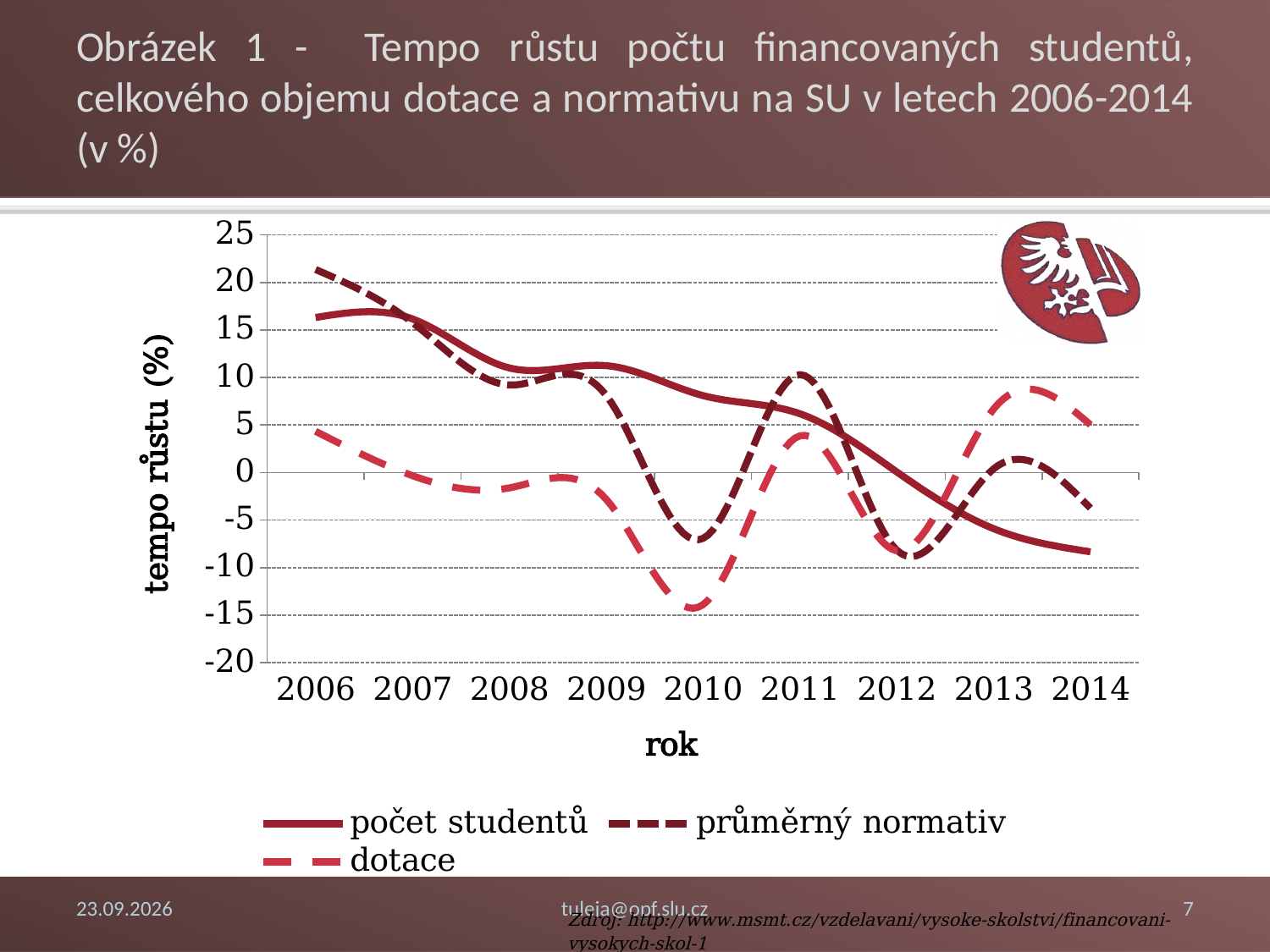
Is the value for 'počet studentů' in 2006 greater or less than 15? greater In which year does the 'dotace' series reach its lowest value? 2010 Is the value for 'dotace' in 2010 greater or less than -10? less How many years are plotted along the x axis? 9 Does the 'počet studentů' series rise or fall from 2006 to 2014? fall What kind of chart is shown on the slide? line chart In 2010, which series has the higher value, 'počet studentů' or 'dotace'? počet studentů Is the value for 'průměrný normativ' in 2006 greater or less than 15? greater In which year does the 'průměrný normativ' series reach its highest value? 2006 How many series does the legend list? 3 What is the title of the y axis? tempo růstu (%)